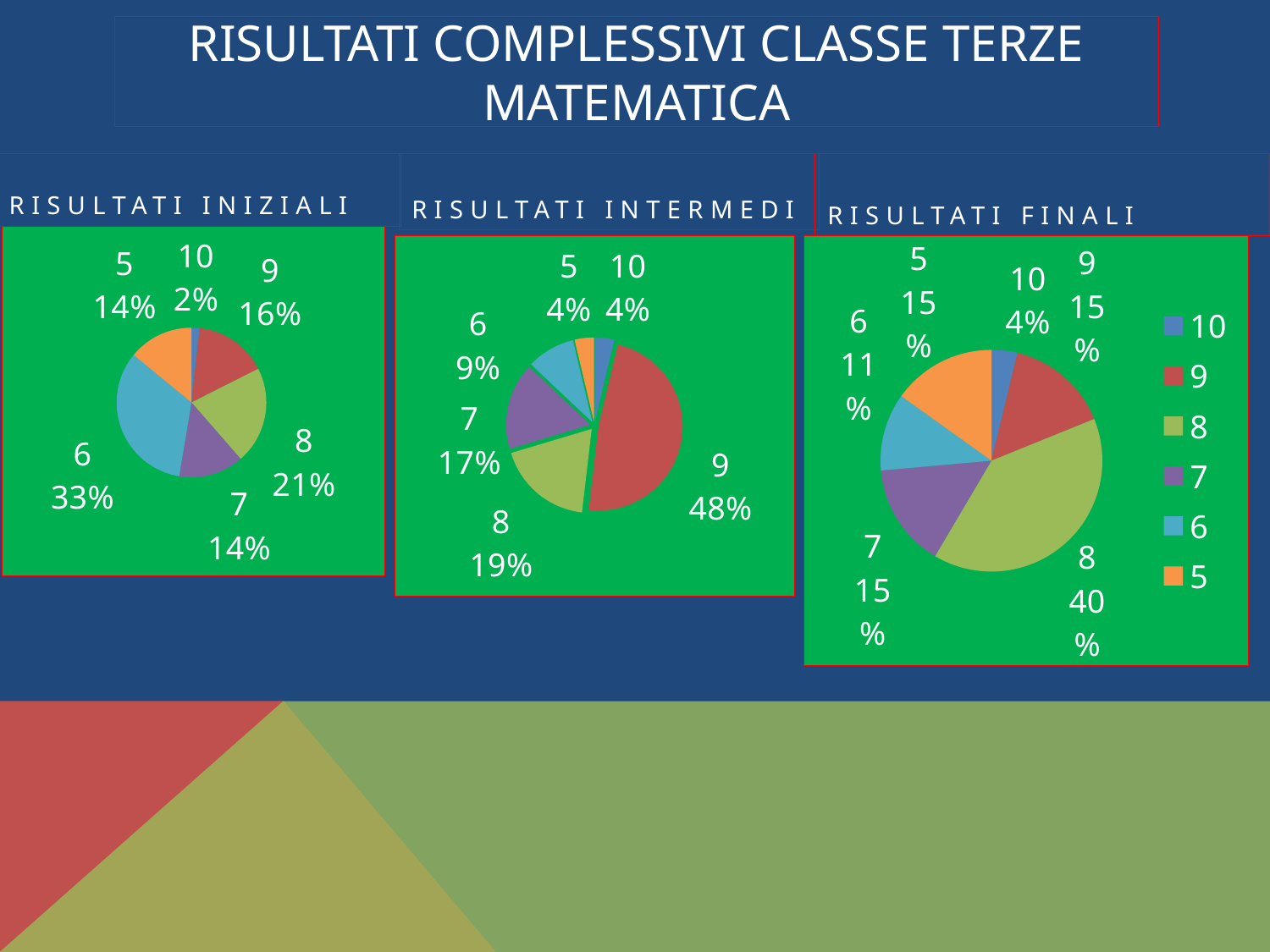
How many slices does the Risultati Finali pie chart have? 6 In the Risultati Intermedi chart, which grade has the largest share? 9 In the Risultati Iniziali chart, what share does grade 6 have? 33% How many entries does the legend of the Risultati Finali chart list? 6 In the Risultati Intermedi chart, what share does grade 9 have? 48% In the Risultati Finali chart, what is the difference between the shares of grade 8 and grade 6? 29% What kind of chart is used for Risultati Iniziali? Pie chart In the Risultati Intermedi chart, which has the larger share, grade 7 or grade 8? 8 In the Risultati Iniziali chart, what is the difference between the shares of grade 8 and grade 9? 5% In the Risultati Iniziali chart, which grade has the smallest share? 10 In the Risultati Finali chart, what share does grade 8 have? 40% In the Risultati Finali chart, which grade has the smallest share? 10